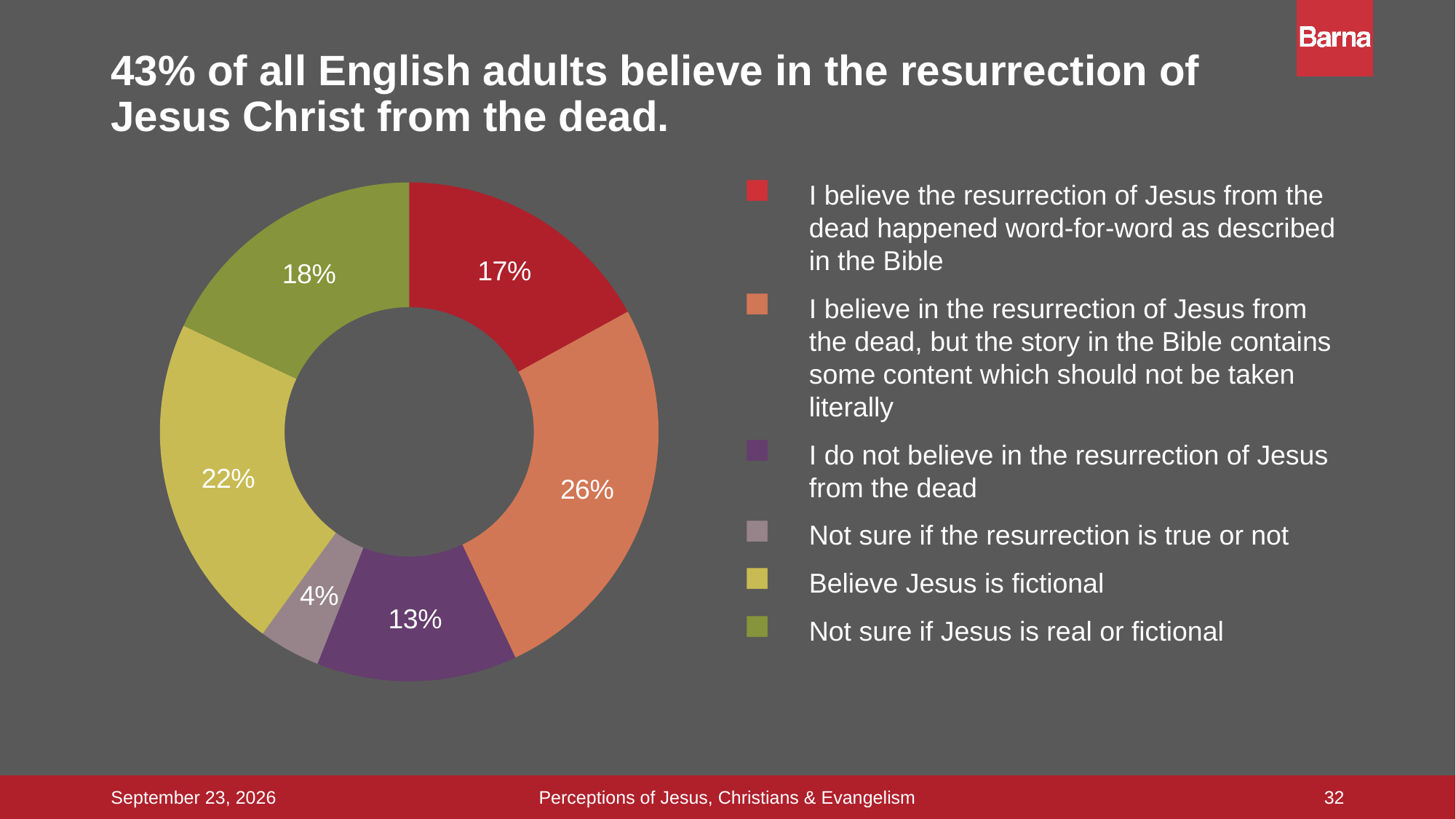
What type of chart is shown on the slide? Doughnut chart How many categories are shown in the chart? 6 Which response has the smallest share of the chart? Not sure if the resurrection is true or not Which is larger: the share who believe the resurrection happened word-for-word as described in the Bible, or the share who do not believe in the resurrection? I believe the resurrection of Jesus from the dead happened word-for-word as described in the Bible What percentage of respondents are not sure if Jesus is real or fictional? 18% What is the difference in percentage points between those who believe Jesus is fictional and those who are not sure if Jesus is real or fictional? 4 What percentage of respondents believe Jesus is fictional? 22% What percentage of respondents are not sure if the resurrection is true or not? 4% What percentage of respondents believe in the resurrection but think the Bible story contains content which should not be taken literally? 26% What percentage of respondents do not believe in the resurrection of Jesus from the dead? 13% Which response has the largest share of the chart? I believe in the resurrection of Jesus from the dead, but the story in the Bible contains some content which should not be taken literally What percentage of respondents believe the resurrection of Jesus from the dead happened word-for-word as described in the Bible? 17%